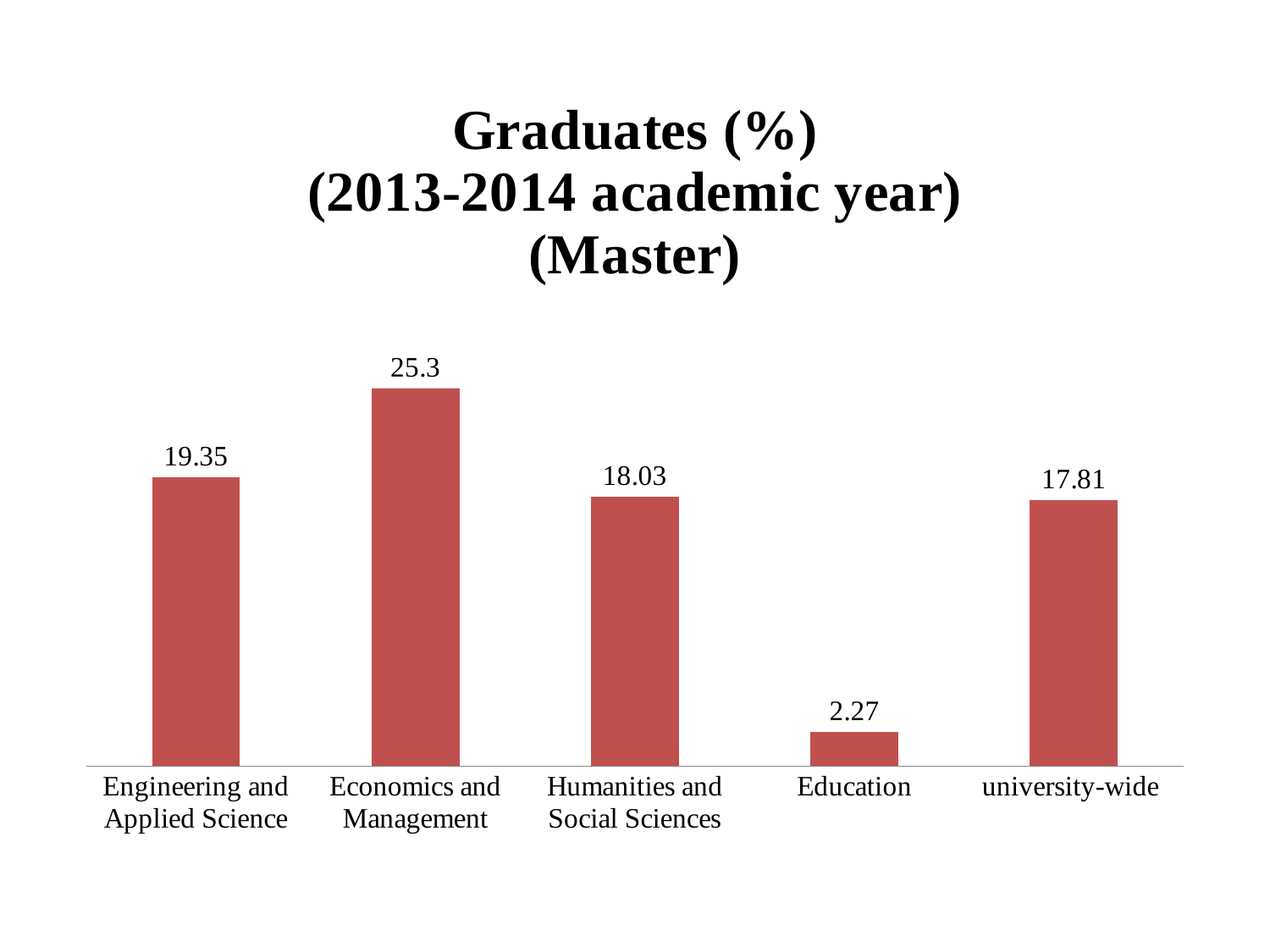
What kind of chart is shown on the slide? Bar chart How many categories are shown in the chart? 5 What is the value for Humanities and Social Sciences? 18.03 Which category has the lowest value? Education What is the title of the chart? Graduates (%) (2013-2014 academic year) (Master) What is the value for Education? 2.27 What is the value for Economics and Management? 25.3 Which is larger, the value for Humanities and Social Sciences or the university-wide value? Humanities and Social Sciences Which category has the highest value? Economics and Management What is the university-wide value? 17.81 What is the value for Engineering and Applied Science? 19.35 What is the difference between the values for Economics and Management and Engineering and Applied Science? 5.95